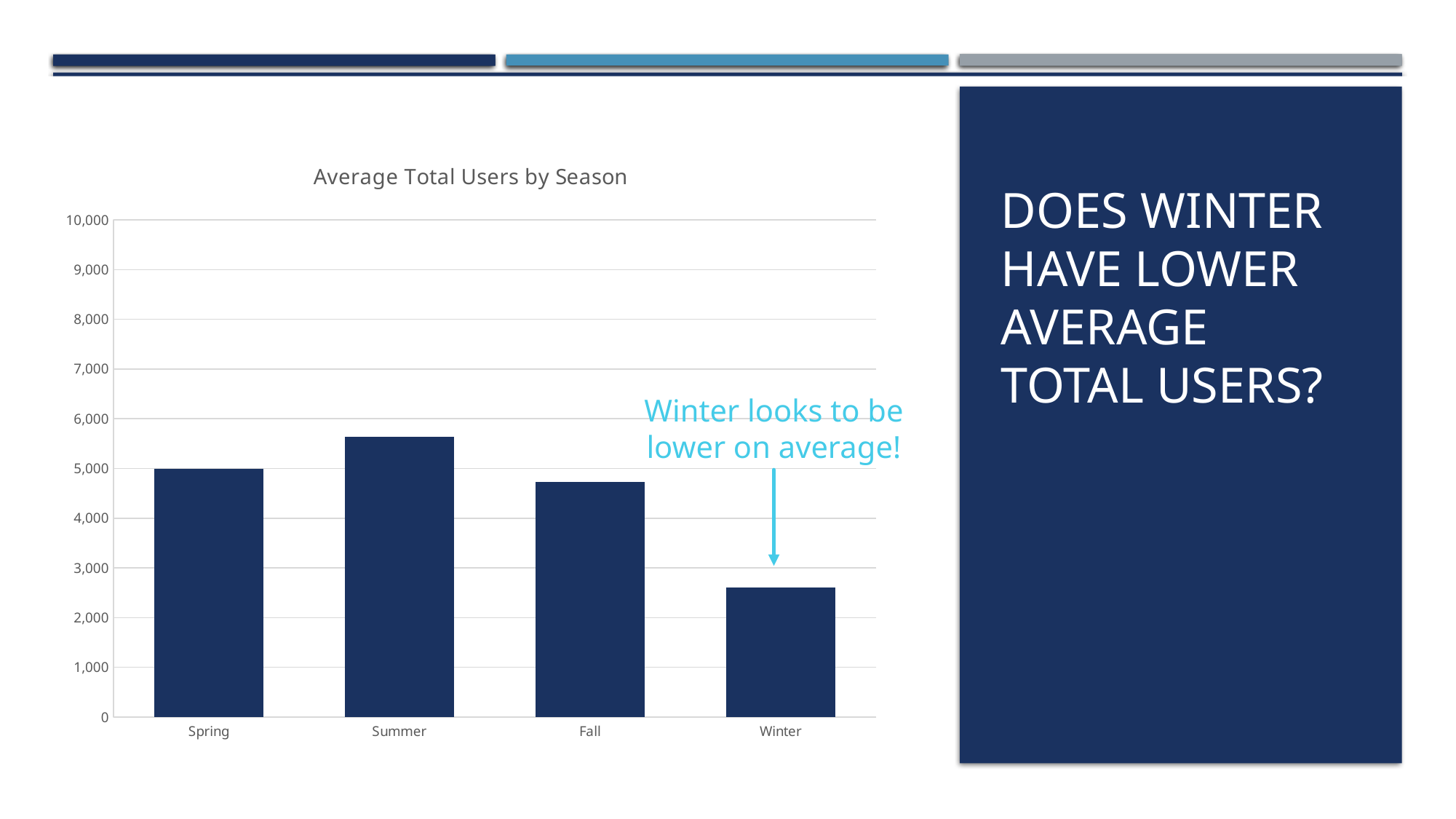
What kind of chart is shown on the slide? bar chart Which has more average total users, Spring or Winter? Spring What is the title of the chart? Average Total Users by Season Which season has the highest average total users? Summer How many seasons are plotted on the chart? 4 Which season has the lowest average total users? Winter Is the value for Fall greater or less than 5,000? less What does the annotation with the arrow pointing at the Winter bar say? Winter looks to be lower on average! Is the value for Summer greater or less than 5,000? greater Which has more average total users, Summer or Fall? Summer Is the value for Winter greater or less than 2,000? greater